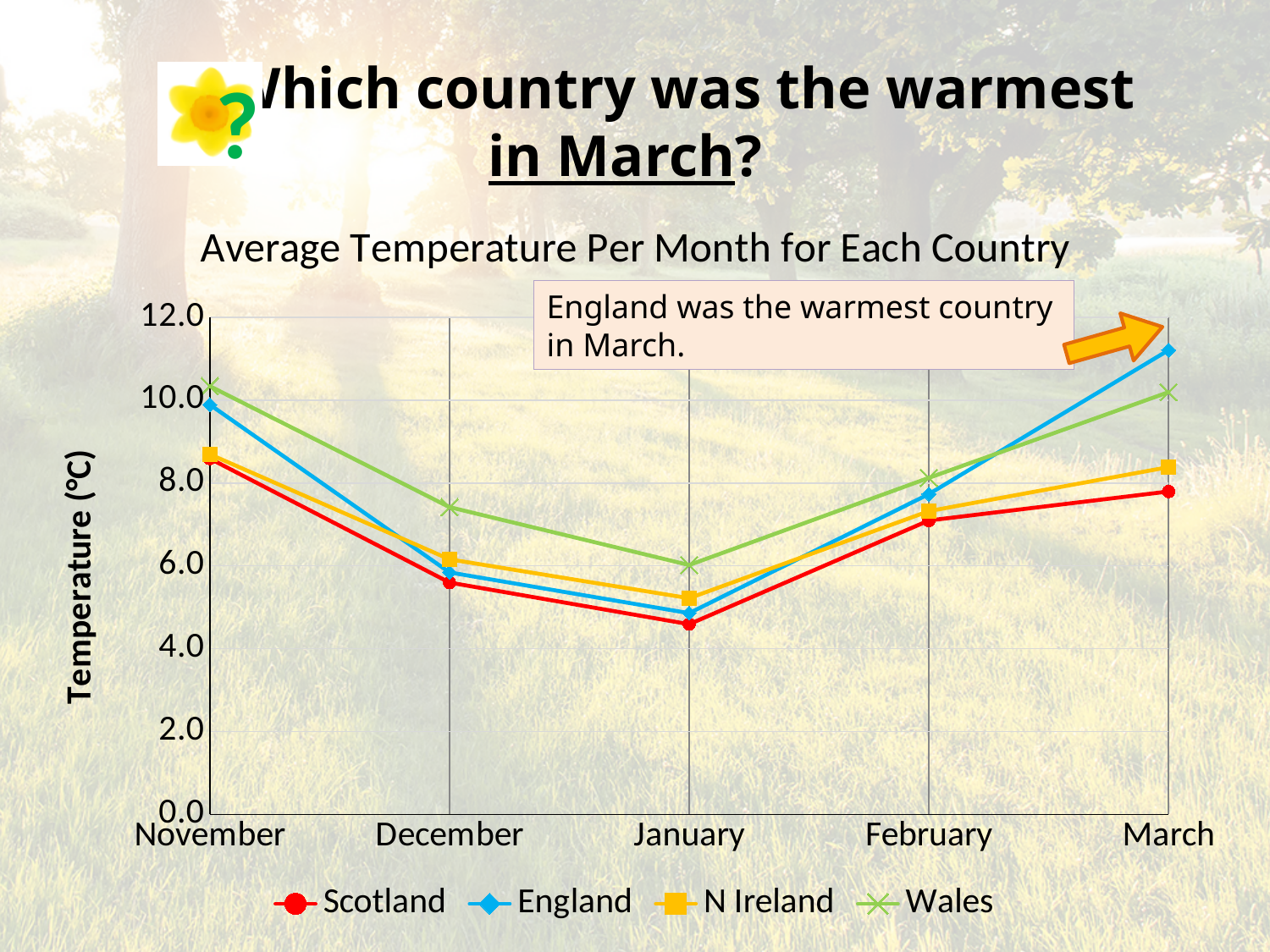
Which country has the lowest average temperature in March? Scotland Which country has the highest average temperature in January? Wales What is the title of the chart? Average Temperature Per Month for Each Country Is the value for England in March greater or less than 10.0? greater How many series does the legend list? 4 Which country has the highest average temperature in March? England How many months are shown on the x axis? 5 Does the Scotland line rise or fall from November to January? fall What kind of chart is shown on the slide? line chart Is the value for Scotland in January greater or less than 6.0? less In November, which is higher: Wales or England? Wales Is the value for Wales in December greater or less than 8.0? less